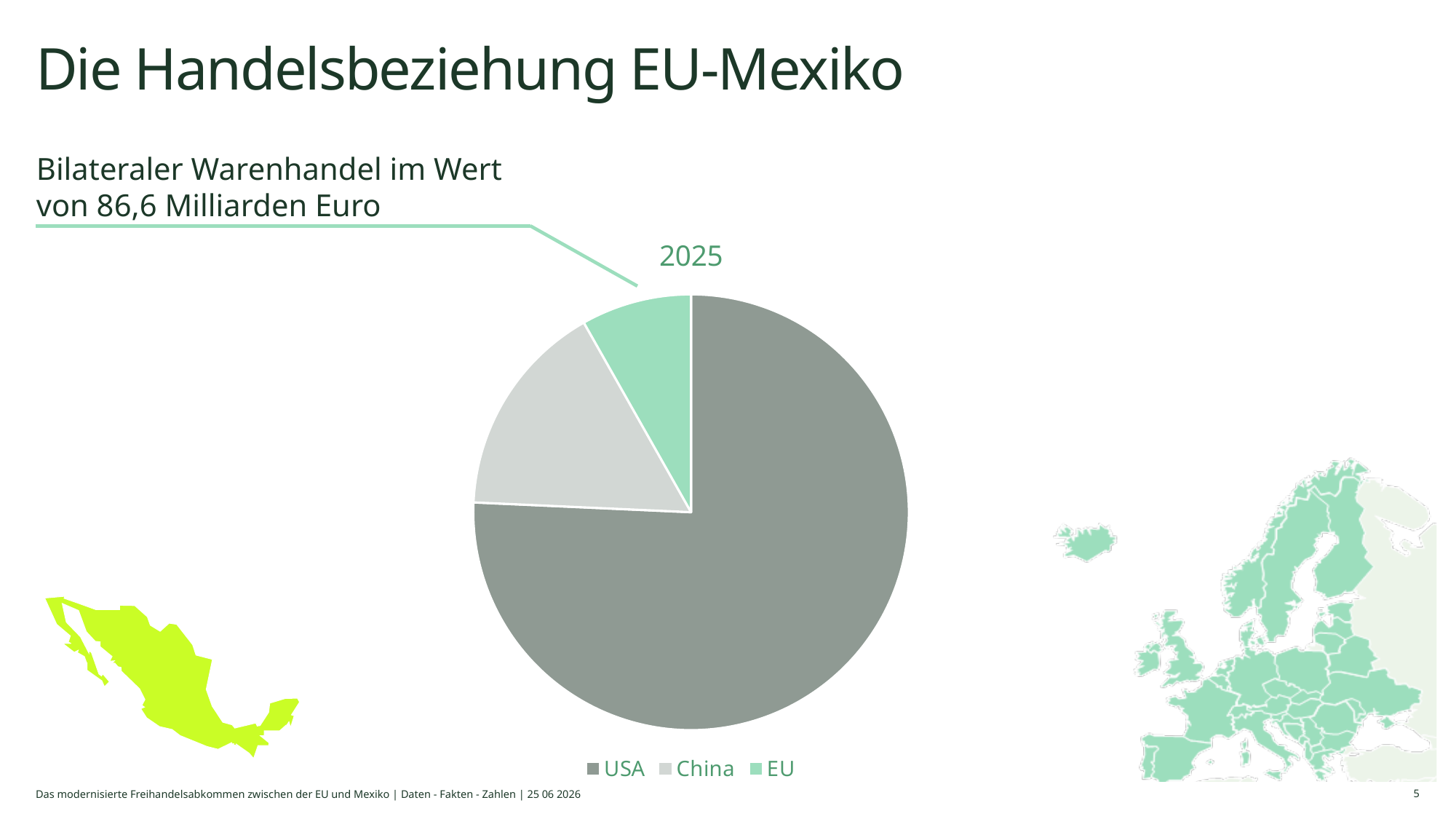
Which legend entry is shown in green in the pie chart? EU How many entries does the legend of the pie chart list? 3 What is the title of the pie chart? 2025 Which slice is larger in the pie chart, China or EU? China How many slices does the pie chart have? 3 Does the USA slice make up more or less than half of the pie chart? more Which category has the largest slice in the pie chart? USA What kind of chart is shown on the slide? pie chart Which category has the smallest slice in the pie chart? EU Which slice is larger in the pie chart, USA or China? USA